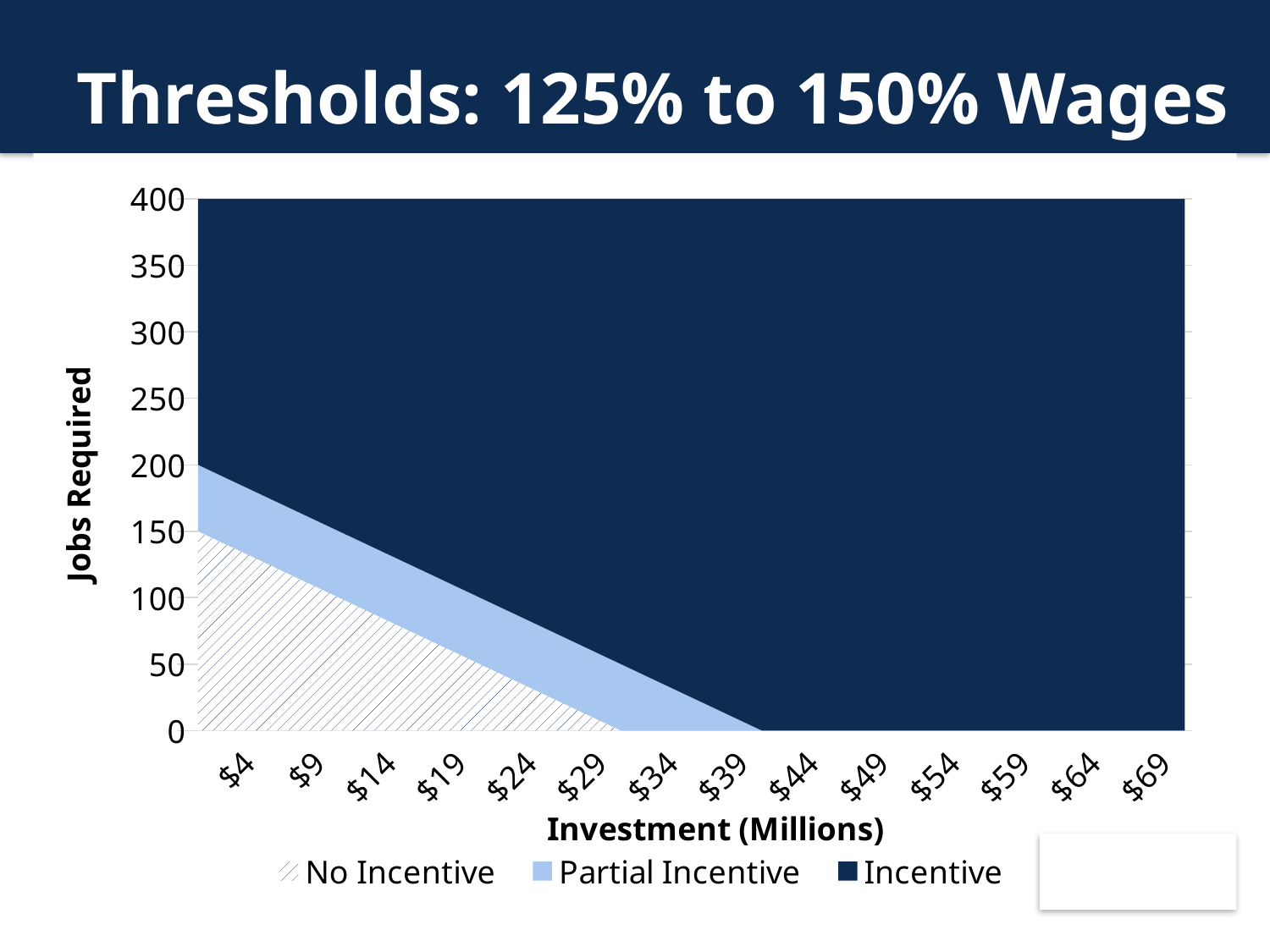
How many series does the legend list? 3 Which series is shown with a hatched pattern? No Incentive How many investment categories are shown on the x axis? 14 Which series occupies the largest area of the chart? Incentive Is the No Incentive value at $49 greater or less than 50? less What kind of chart is shown on the slide? Area chart Does the No Incentive area rise or fall as investment increases along the x axis? Fall Is the No Incentive value at $19 greater or less than 100? less What is the title of the chart? Thresholds: 125% to 150% Wages What is the label of the y axis? Jobs Required